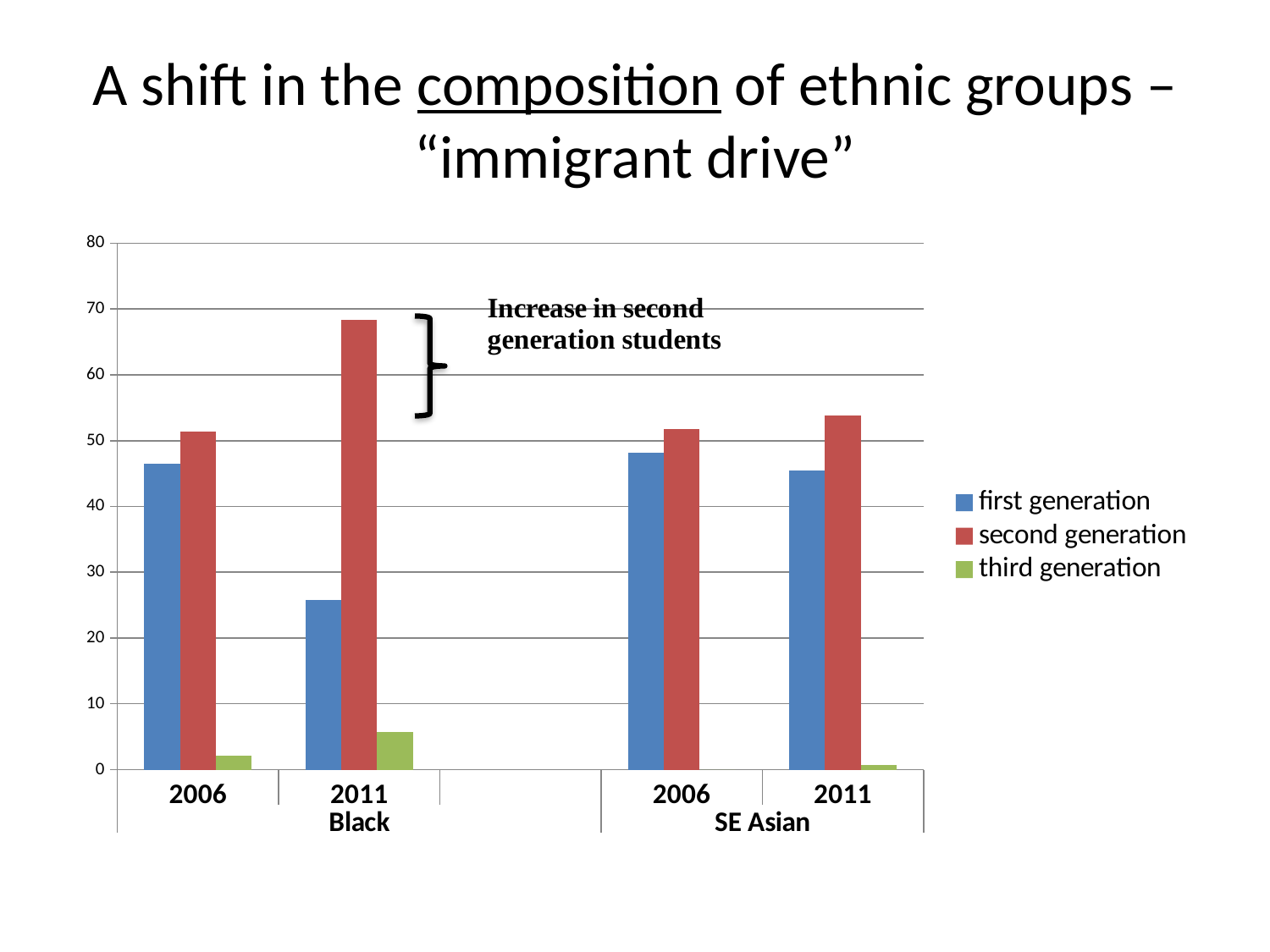
Did the first generation value for Black rise or fall from 2006 to 2011? fall What does the annotation next to the bracket on the chart say? Increase in second generation students Is the second generation value for Black in 2011 greater or less than 60? greater What kind of chart is shown on the slide? bar chart Did the second generation value for Black rise or fall from 2006 to 2011? rise Is the first generation value for Black in 2006 greater or less than 40? greater For which group and year is the second generation bar highest? Black 2011 Is the third generation value for Black in 2011 greater or less than 10? less Which series has the tallest bar in the whole chart? second generation How many series does the legend list? 3 Which is larger for Black in 2011: first generation or second generation? second generation